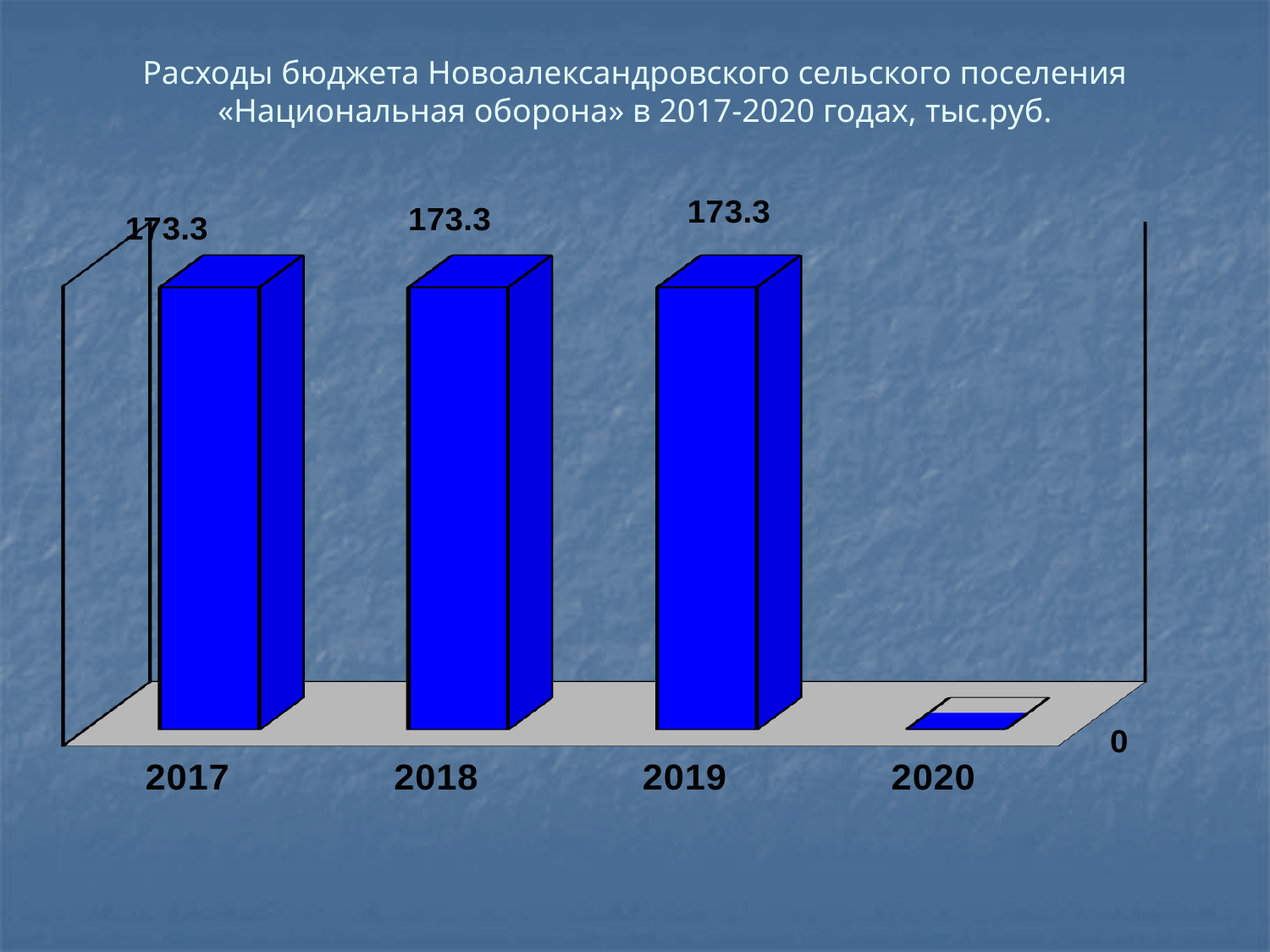
What is the value for 2019? 173.3 What is the value for 2020? 0 Which is larger, the value for 2018 or the value for 2020? 2018 What is the value for 2017? 173.3 Which year has the lowest value? 2020 Do the values rise or fall from 2019 to 2020? Fall What is the value for 2018? 173.3 In what units are the values given according to the chart title? тыс.руб. What is the difference between the values for 2019 and 2020? 173.3 How many years are shown on the x axis? 4 What kind of chart is shown on the slide? Bar chart Are the values for 2017 and 2018 equal? Yes